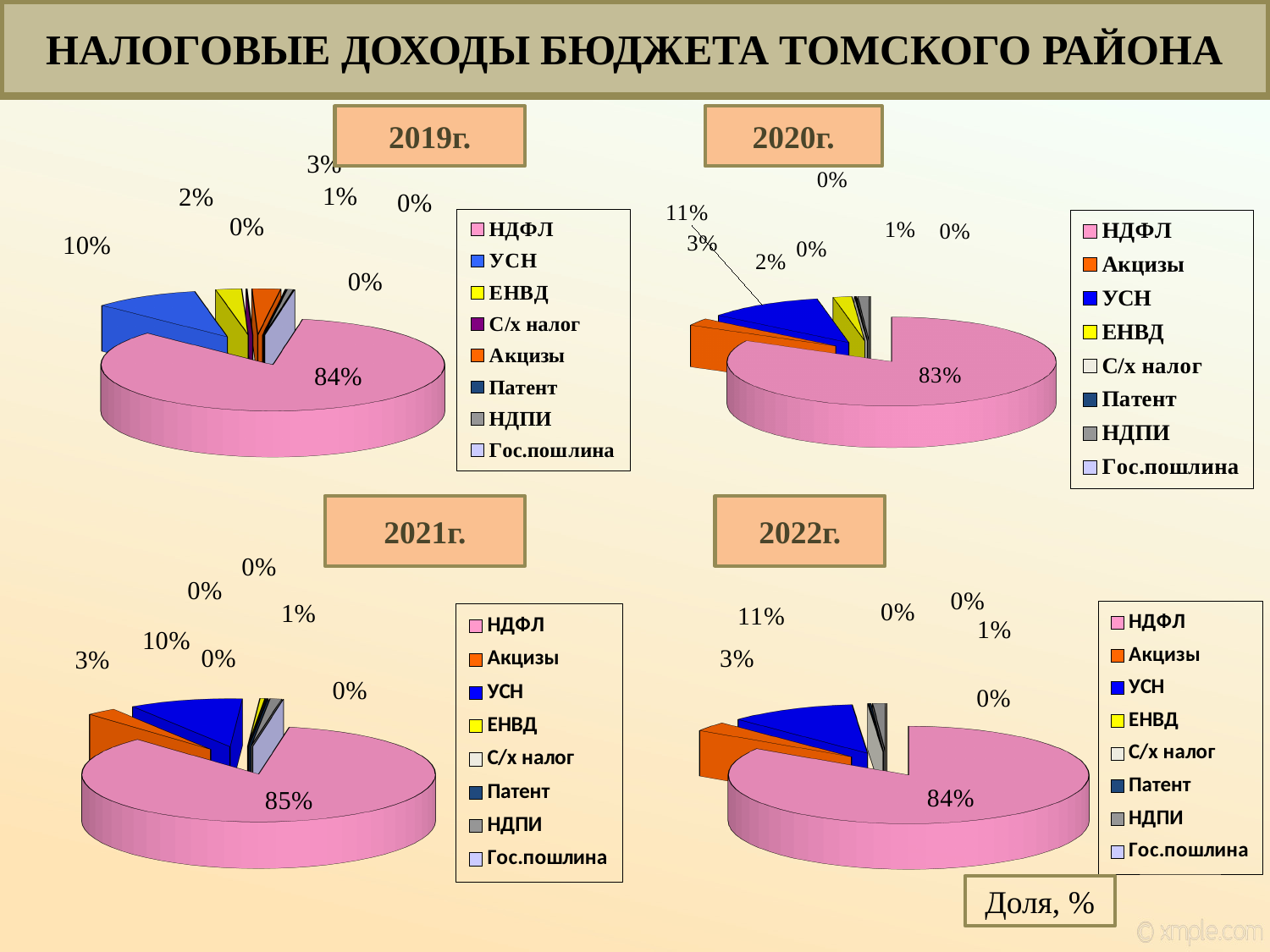
In the 2021г. chart, which category has the largest share? НДФЛ What is the first entry in the legend of the 2022г. chart? НДФЛ In the 2019г. chart, what share is labelled on the largest (pink) slice? 84% What unit label is shown in the box at the bottom right of the slide? Доля, % In the 2020г. chart, what share is labelled on the largest (pink) slice? 83% In the 2022г. chart, what share is labelled on the largest (pink) slice? 84% How many entries does the legend of the 2020г. chart list? 8 What kind of chart is used for the 2019г. data? pie chart What is the difference between the НДФЛ share in the 2021г. chart (85%) and in the 2020г. chart (83%)? 2% How many pie charts are shown on the slide? 4 Which is larger: the НДФЛ share in the 2021г. chart or in the 2020г. chart? 2021г.